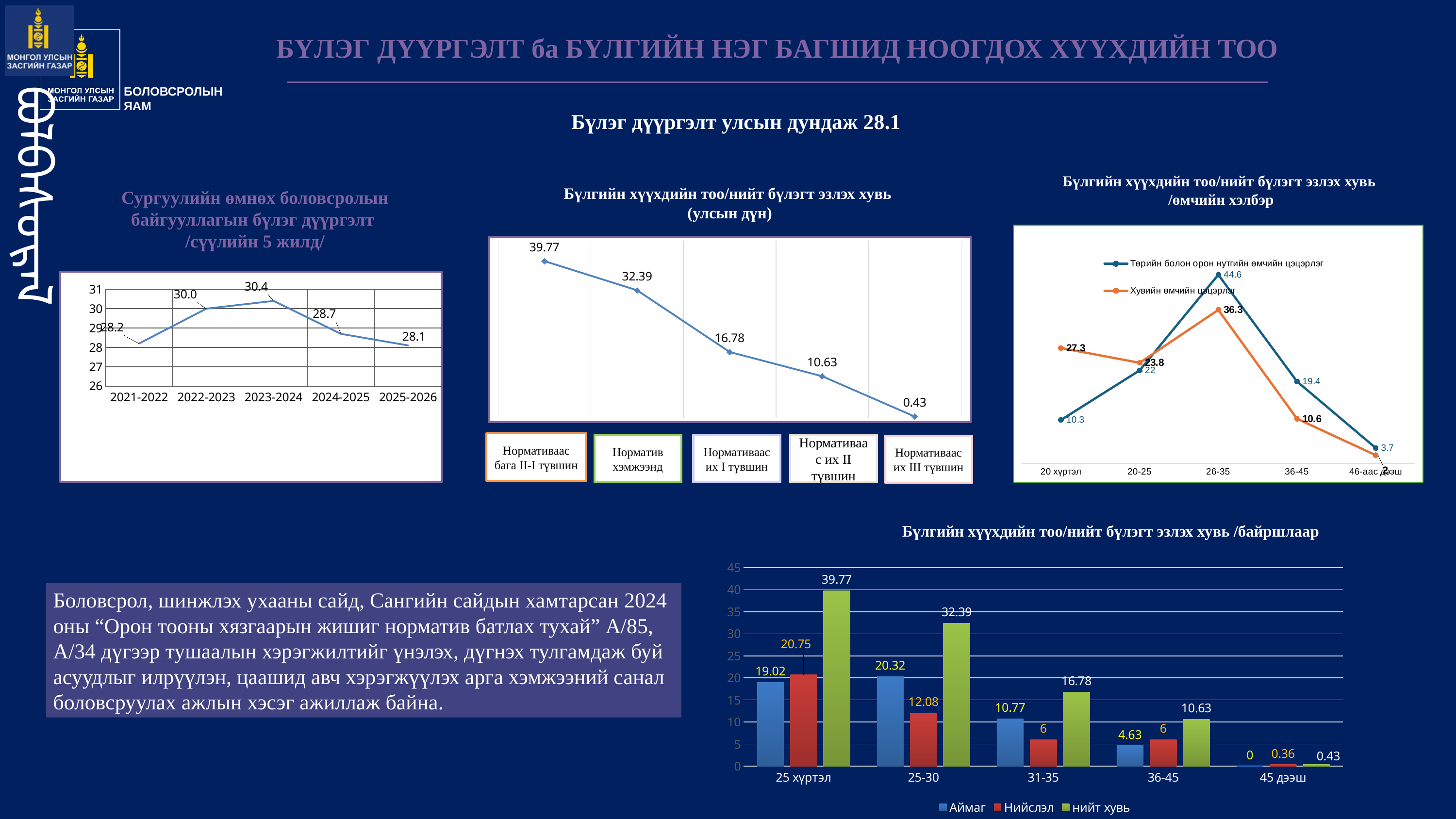
In the top-left chart 'Сургуулийн өмнөх боловсролын байгууллагын бүлэг дүүргэлт /сүүлийн 5 жилд/', what is the difference between the 2023-2024 and 2021-2022 values? 2.2 In the top-left chart 'Сургуулийн өмнөх боловсролын байгууллагын бүлэг дүүргэлт /сүүлийн 5 жилд/', which year has the lowest value? 2025-2026 In the bottom-right chart 'Бүлгийн хүүхдийн тоо/нийт бүлэгт эзлэх хувь /байршлаар', what is the value for 'Нийслэл' at '25-30'? 12.08 In the top-left chart 'Сургуулийн өмнөх боловсролын байгууллагын бүлэг дүүргэлт /сүүлийн 5 жилд/', how many years are plotted? 5 In the top-right chart 'Бүлгийн хүүхдийн тоо/нийт бүлэгт эзлэх хувь /өмчийн хэлбэр', which series has the larger value at '20 хүртэл'? Хувийн өмчийн цэцэрлэг In the top-right chart 'Бүлгийн хүүхдийн тоо/нийт бүлэгт эзлэх хувь /өмчийн хэлбэр', what is the value for 'Хувийн өмчийн цэцэрлэг' at '26-35'? 36.3 In the top-left chart 'Сургуулийн өмнөх боловсролын байгууллагын бүлэг дүүргэлт /сүүлийн 5 жилд/', what is the value for 2023-2024? 30.4 In the middle chart 'Бүлгийн хүүхдийн тоо/нийт бүлэгт эзлэх хувь (улсын дүн)', do the values rise or fall from left to right? fall In the middle chart 'Бүлгийн хүүхдийн тоо/нийт бүлэгт эзлэх хувь (улсын дүн)', what is the value for 'Норматив хэмжээнд'? 32.39 How many series does the legend of the top-right chart 'Бүлгийн хүүхдийн тоо/нийт бүлэгт эзлэх хувь /өмчийн хэлбэр' list? 2 In the bottom-right chart 'Бүлгийн хүүхдийн тоо/нийт бүлэгт эзлэх хувь /байршлаар', what is the difference between 'Нийслэл' and 'Аймаг' at '25 хүртэл'? 1.73 What kind of chart is the middle chart 'Бүлгийн хүүхдийн тоо/нийт бүлэгт эзлэх хувь (улсын дүн)'? line chart